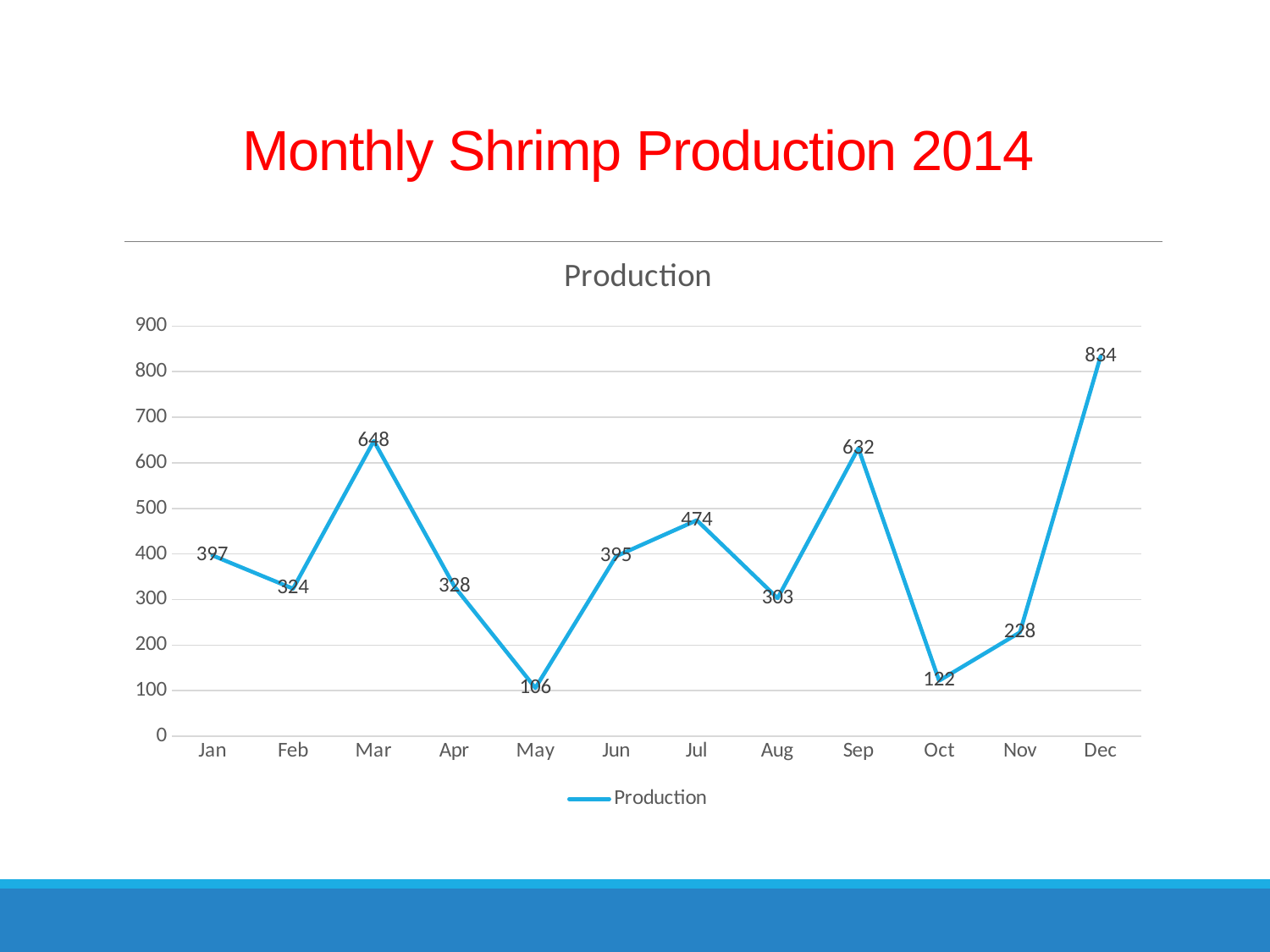
Which month has the lowest production? May Does production rise or fall from September to October? Fall What is the difference between the production in December and the production in May? 728 How many months are plotted on the chart? 12 What is the difference between the production in September and the production in August? 329 Which month has the highest production? Dec What is the production value for March? 648 Which month has higher production, January or November? Jan What is the production value for October? 122 Is the production value for June greater or less than 300? greater What is the production value for July? 474 What type of chart is shown on the slide? Line chart